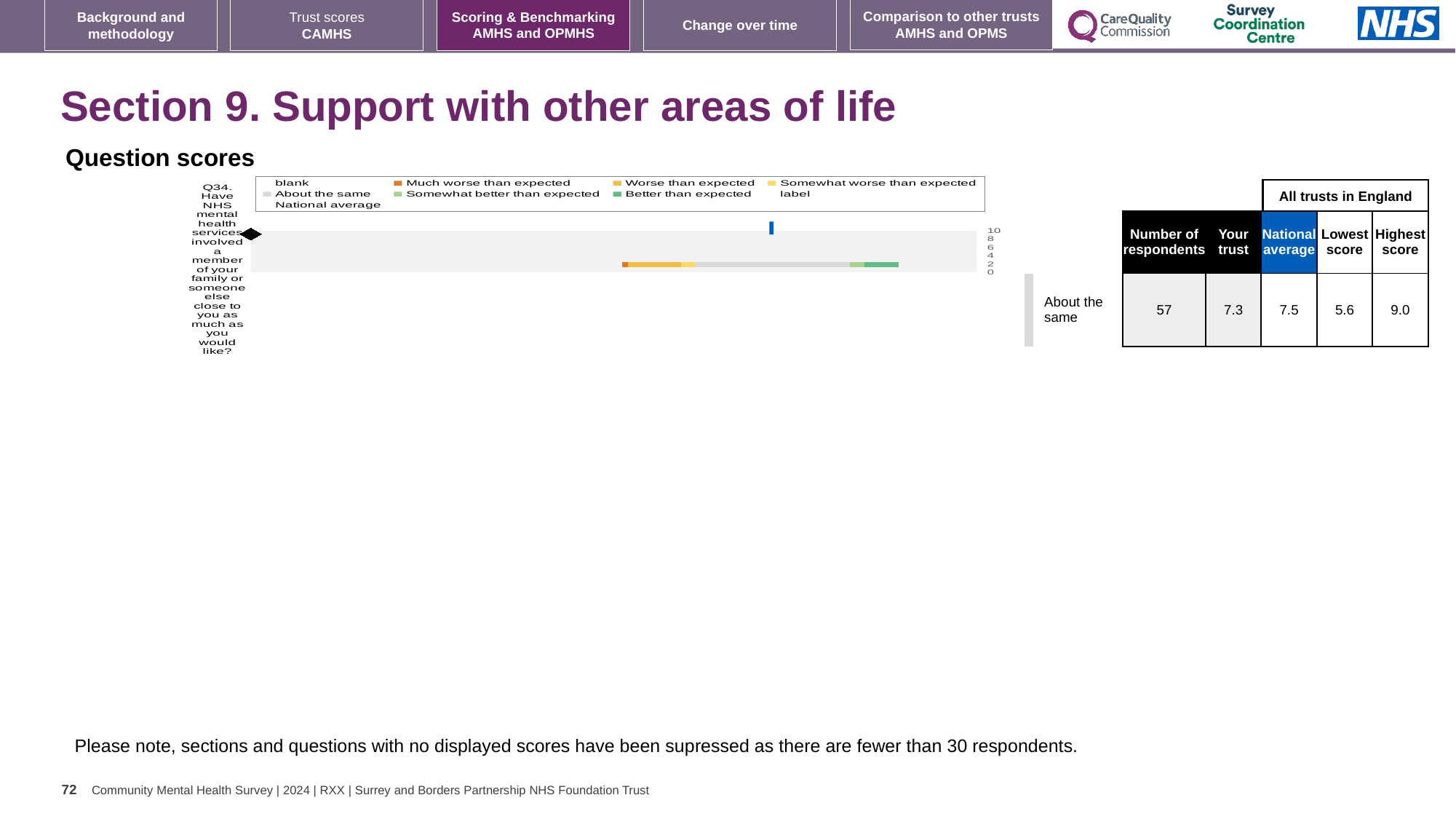
What is the 'Your trust' score for Q34? 7.3 What is the difference between the highest score and the lowest score for Q34? 3.4 Which question number is plotted in the Question scores chart? Q34 How many questions are plotted in the Question scores chart? 1 What is the national average score for Q34? 7.5 What is the highest score among all trusts in England for Q34? 9.0 What is the number of respondents shown for Q34? 57 What is the lowest score among all trusts in England for Q34? 5.6 What kind of chart is used to show the Q34 question score? bar chart What benchmark category label is shown next to the Q34 bar? About the same For Q34, which is larger: the 'Your trust' score or the national average? National average Is the national average marker for Q34 greater or less than 6 on the axis? greater